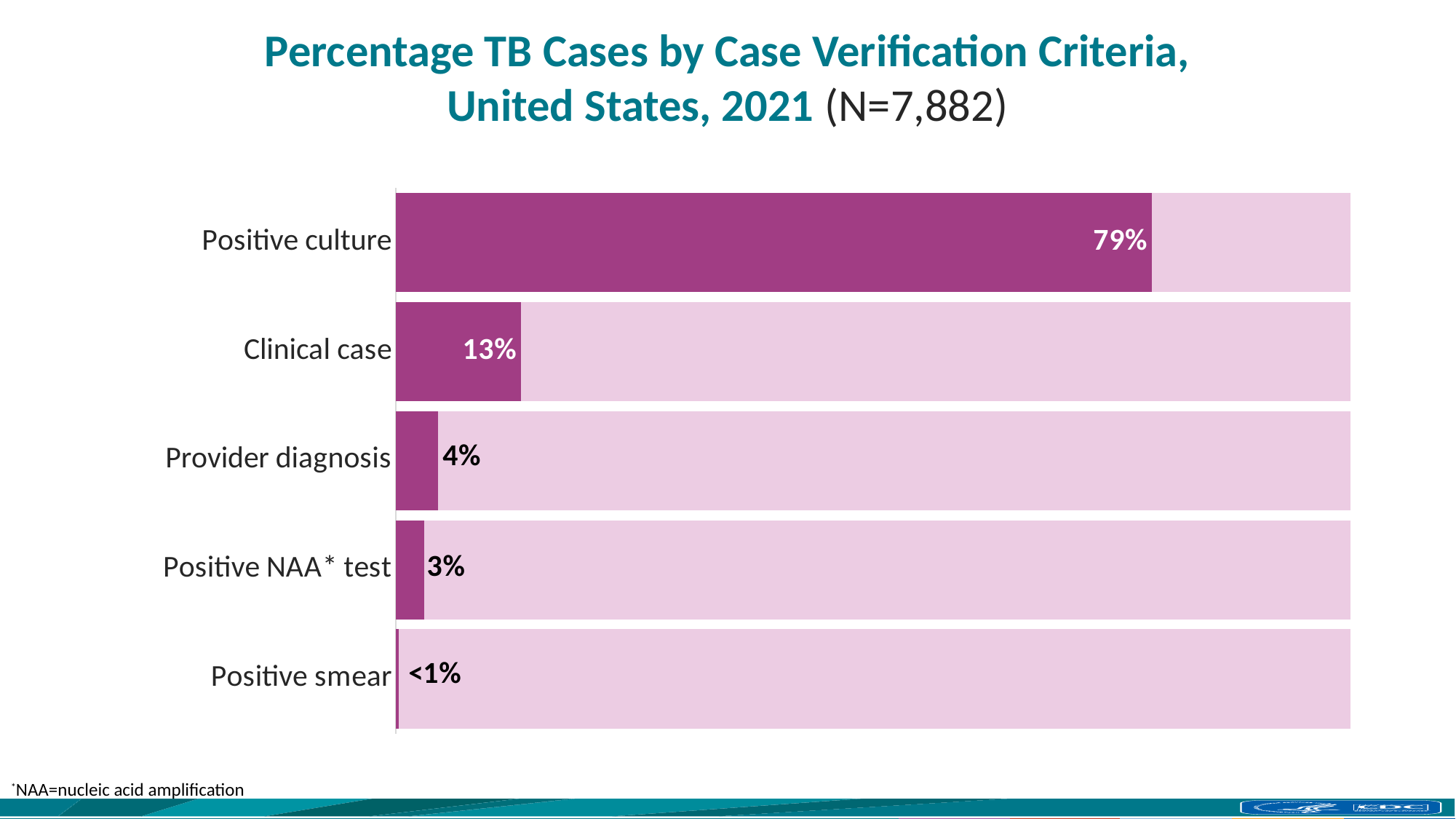
What percentage of TB cases were verified as clinical case? 13% What kind of chart is shown on the slide? Bar chart What value is shown for positive smear? <1% Which is larger, the percentage for provider diagnosis or for positive NAA test? Provider diagnosis Which case verification criterion has the lowest percentage of TB cases? Positive smear What is the difference in percentage points between positive culture and clinical case? 66 What does NAA stand for according to the footnote? Nucleic acid amplification What percentage of TB cases were verified by positive culture? 79% What percentage of TB cases were verified by provider diagnosis? 4% What percentage of TB cases were verified by positive NAA test? 3% Which case verification criterion has the highest percentage of TB cases? Positive culture How many case verification criteria are shown in the chart? 5